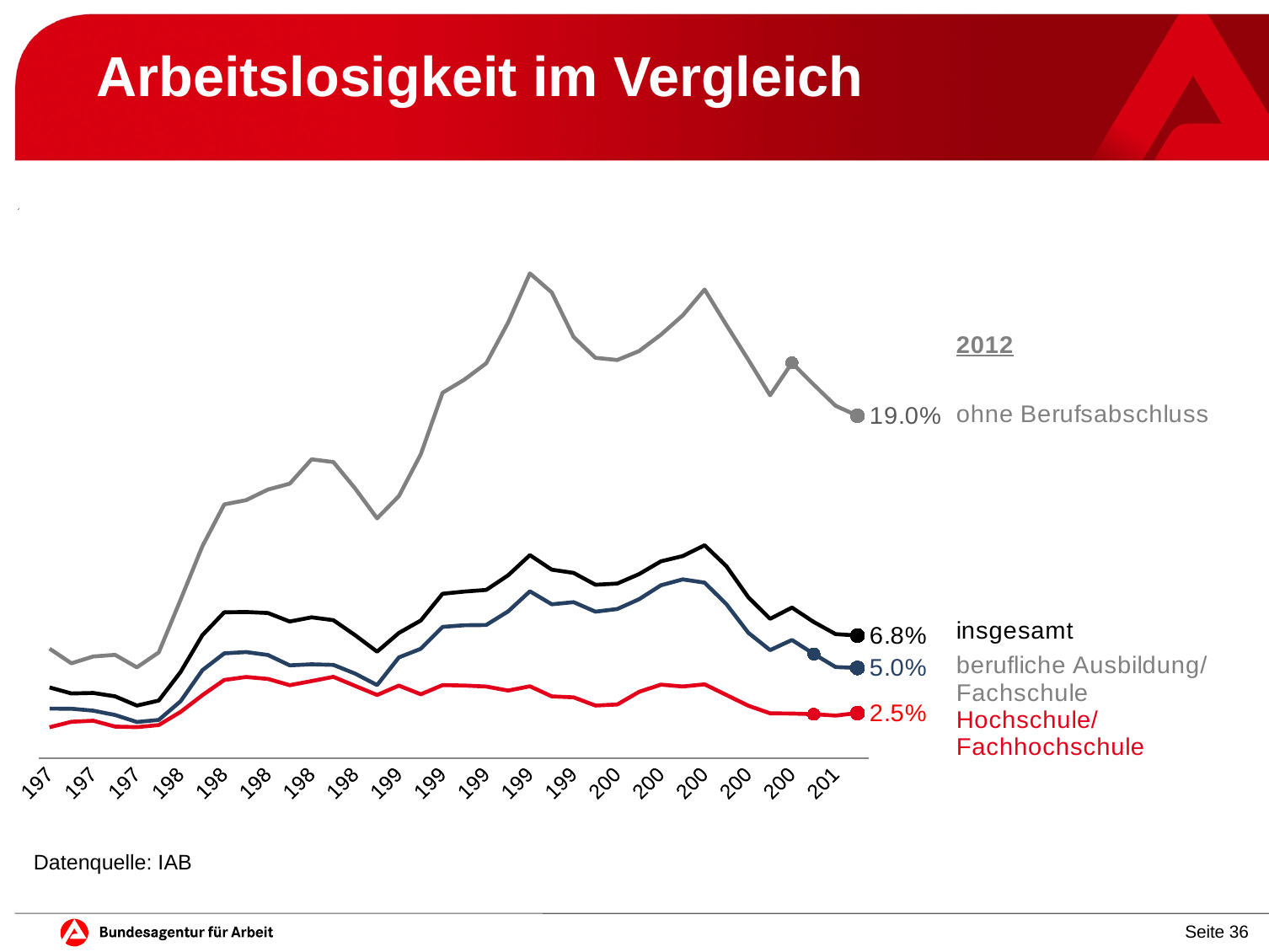
What is the difference between the 2012 values for "insgesamt" and "berufliche Ausbildung/Fachschule"? 1.8 percentage points Which group has the lowest unemployment rate in 2012? Hochschule/Fachhochschule How many series (lines) are plotted in the chart? 4 In 2012, which is larger: the value for "insgesamt" or for "berufliche Ausbildung/Fachschule"? insgesamt What kind of chart is shown on the slide? Line chart What is the 2012 value shown for "Hochschule/Fachhochschule"? 2.5% What is the 2012 value shown for "berufliche Ausbildung/Fachschule"? 5.0% What is the 2012 unemployment rate shown for "ohne Berufsabschluss"? 19.0% What is the difference between the 2012 values for "ohne Berufsabschluss" and "Hochschule/Fachhochschule"? 16.5 percentage points What is the data source given below the chart? IAB What is the 2012 value shown for "insgesamt"? 6.8% Which group has the highest unemployment rate in 2012? ohne Berufsabschluss